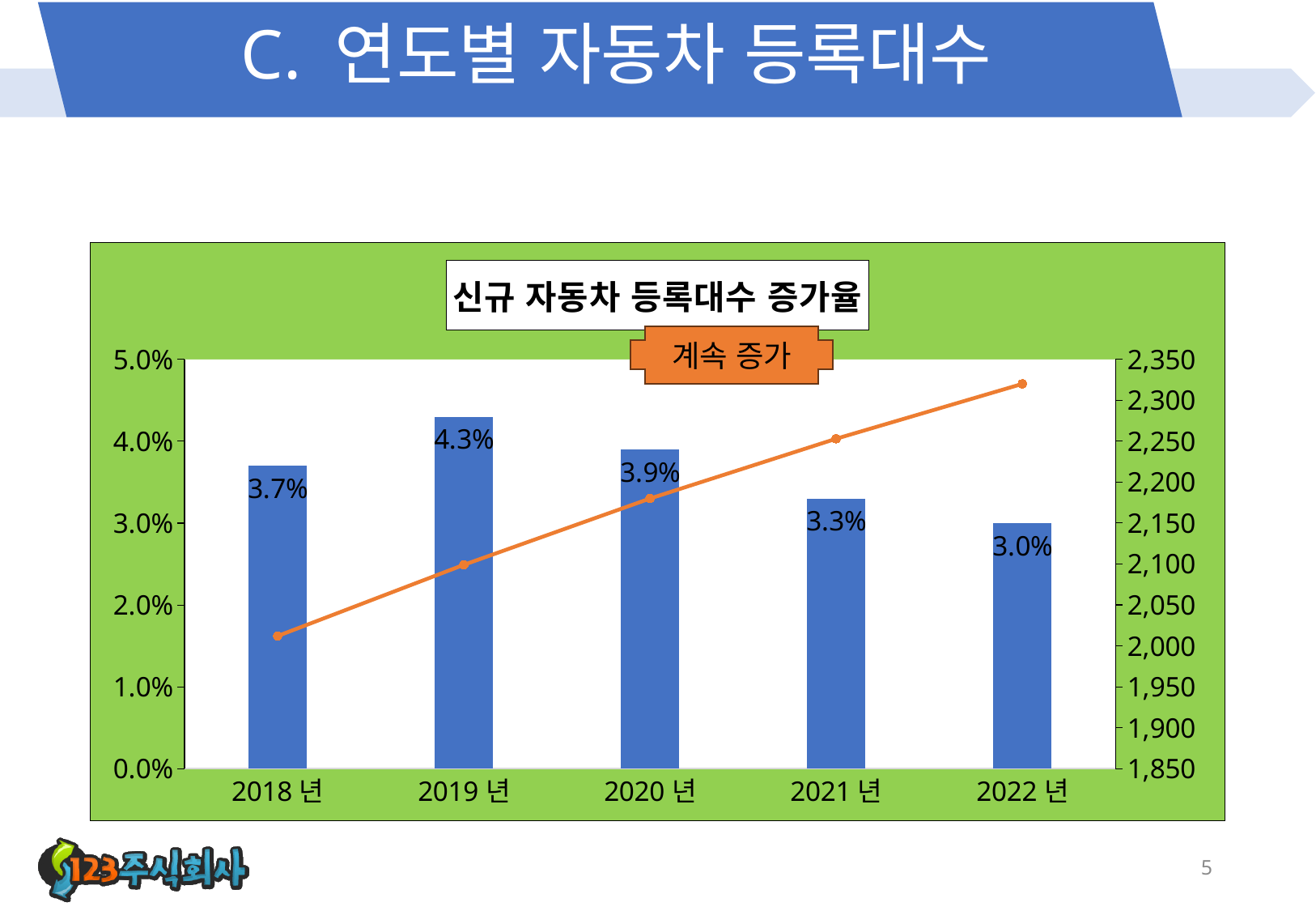
Which year has a higher growth rate, 2018 년 or 2020 년? 2020 년 What is the growth rate shown for 2019 년? 4.3% Is the line value for 2022 년 on the right axis greater or less than 2,300? greater Which year has the highest growth rate bar? 2019 년 Do the growth rate bars rise or fall from 2019 년 to 2022 년? fall What is the growth rate shown for 2022 년? 3.0% Does the orange line rise or fall from 2018 년 to 2022 년? rise What is the title of the chart? 신규 자동차 등록대수 증가율 How many years are shown on the x axis? 5 What is the difference between the growth rates for 2019 년 and 2021 년? 1.0% Is the line value for 2018 년 on the right axis greater or less than 2,050? less Which year has the lowest growth rate bar? 2022 년